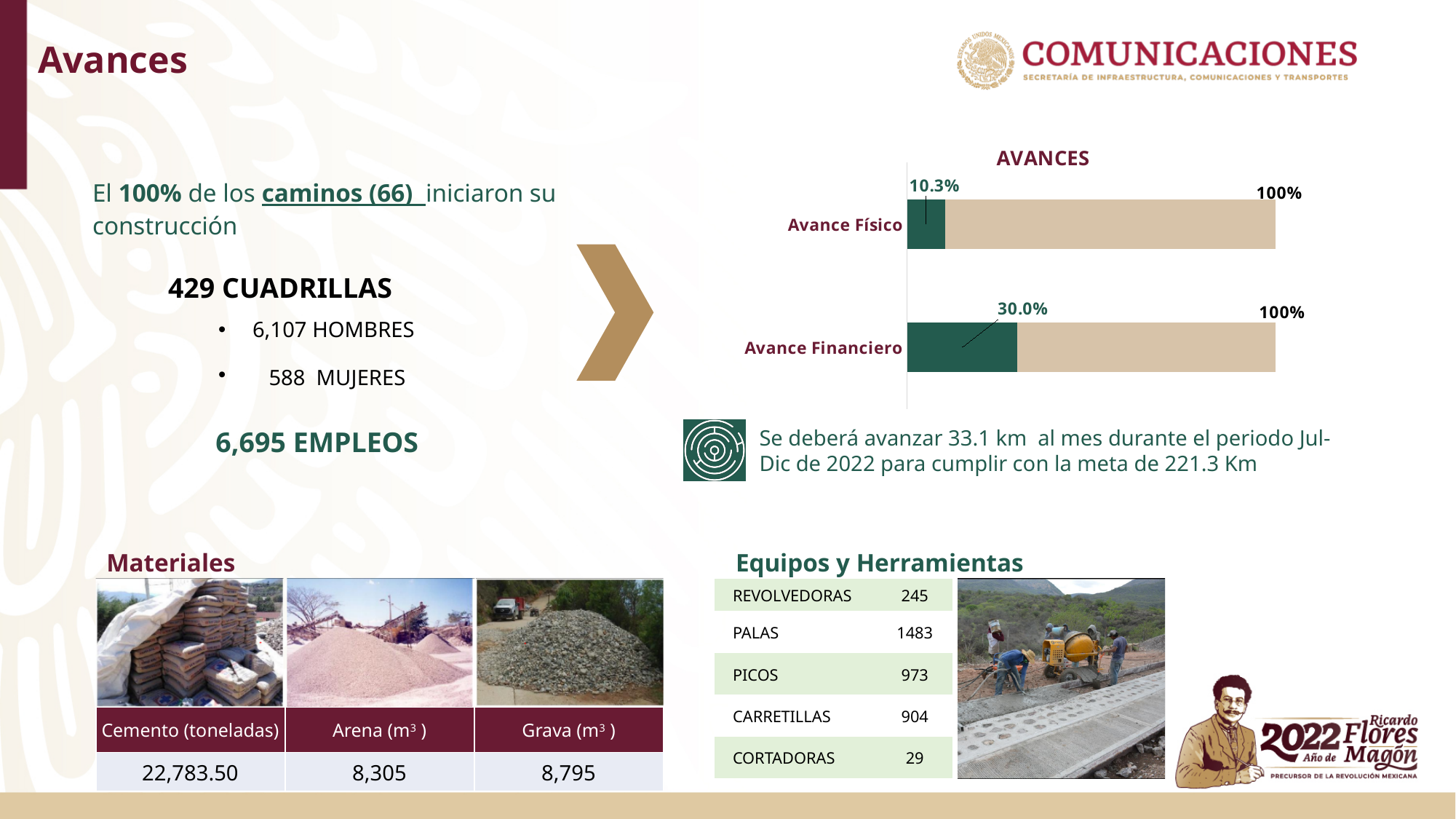
In the AVANCES chart, which category has the lowest progress value? Avance Físico In the AVANCES chart, what is the progress value labelled for Avance Financiero? 30.0% In the AVANCES chart, which category is listed first from the top? Avance Físico In the AVANCES chart, what colour are the progress bars (10.3% and 30.0%)? dark green What type of chart is shown under the title AVANCES? bar chart In the AVANCES chart, which category has the higher progress value, Avance Físico or Avance Financiero? Avance Financiero What is the title of the chart on the slide? AVANCES In the AVANCES chart, what is the progress value labelled for Avance Físico? 10.3% In the AVANCES chart, what is the difference between the progress values of Avance Financiero and Avance Físico? 19.7% In the AVANCES chart, what value is labelled at the end of the tan bar for Avance Físico? 100% How many categories does the AVANCES chart show? 2